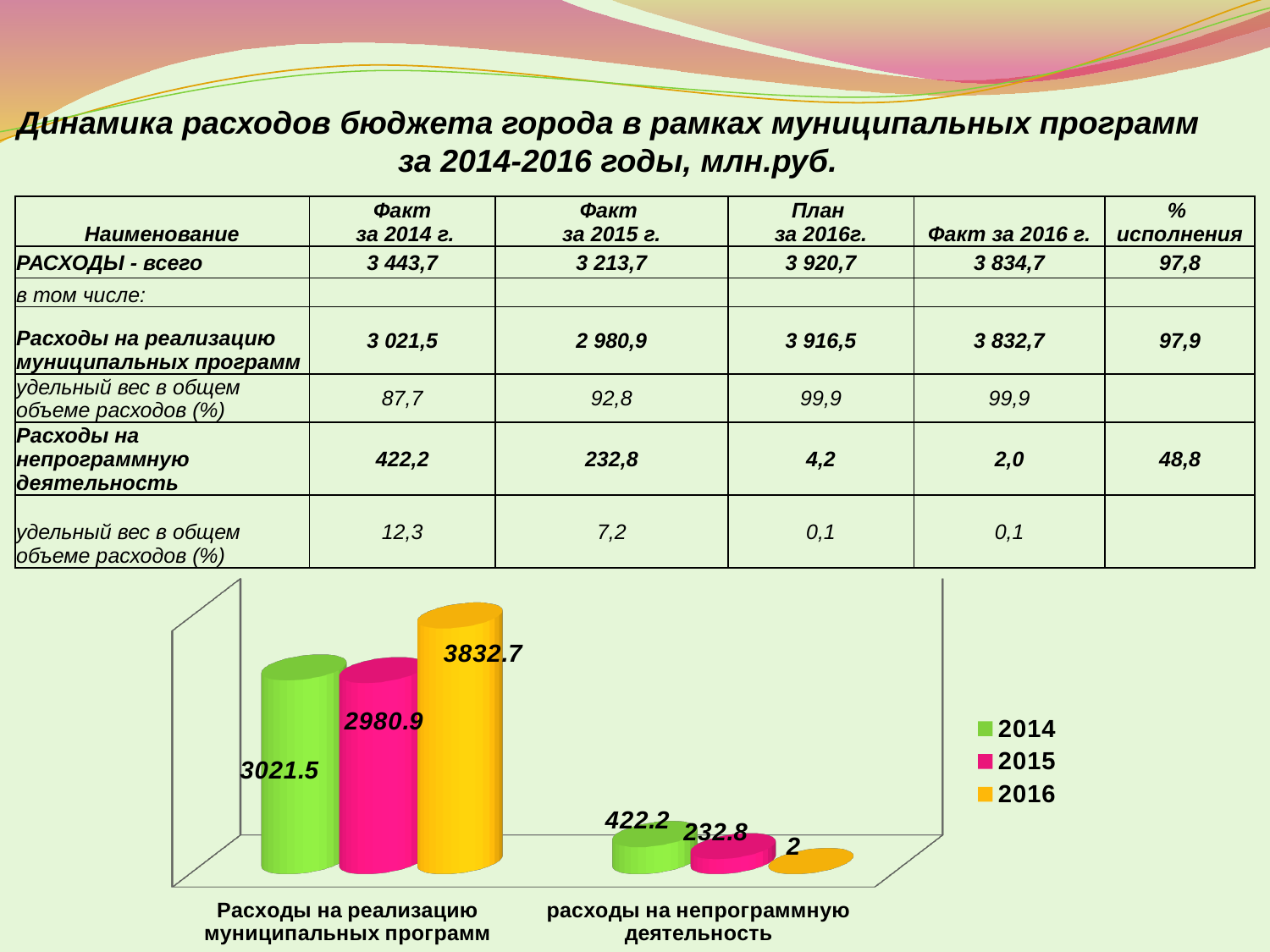
What is the value for 2016 in the category 'Расходы на реализацию муниципальных программ'? 3832.7 How many series does the chart legend list? 3 Which is larger in the category 'расходы на непрограммную деятельность': the value for 2014 or the value for 2015? 2014 What is the value for 2016 in the category 'расходы на непрограммную деятельность'? 2 How many categories are shown on the x axis of the chart? 2 What is the value for 2015 in the category 'Расходы на реализацию муниципальных программ'? 2980.9 Which colour represents the 2015 series in the chart? pink Which year has the lowest value in the category 'расходы на непрограммную деятельность'? 2016 What kind of chart is shown on the slide? bar chart What is the value for 2014 in the category 'расходы на непрограммную деятельность'? 422.2 Which year has the highest value in the category 'Расходы на реализацию муниципальных программ'? 2016 What is the difference between the 2016 and 2014 values in the category 'Расходы на реализацию муниципальных программ'? 811.2